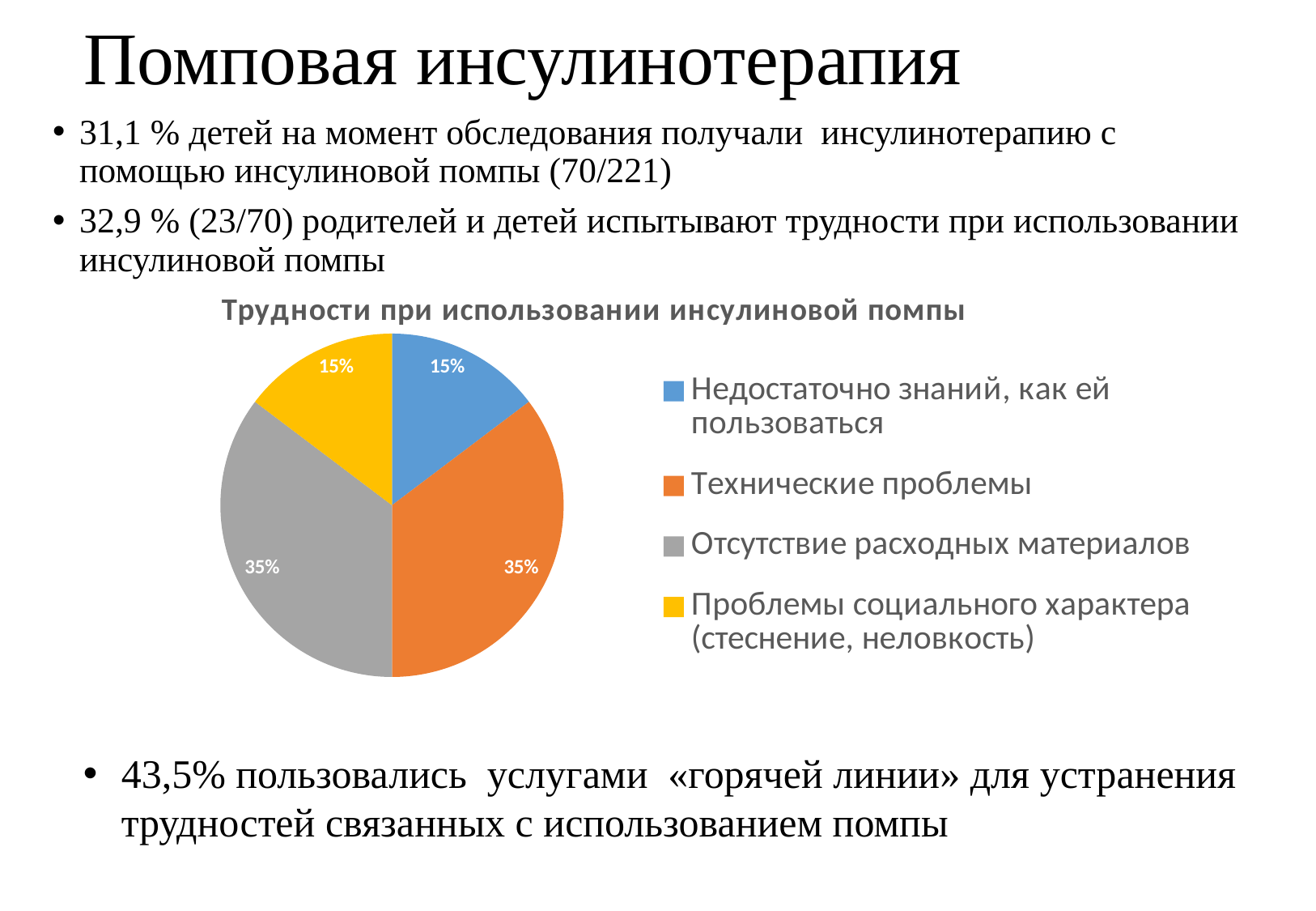
What kind of chart is shown on the slide? Pie chart What is the difference in percentage points between the share for 'Отсутствие расходных материалов' and the share for 'Проблемы социального характера (стеснение, неловкость)'? 20 What share of the pie is 'Проблемы социального характера (стеснение, неловкость)'? 15% What share of the pie is 'Недостаточно знаний, как ей пользоваться'? 15% What share of the pie is 'Технические проблемы'? 35% Which colour represents 'Технические проблемы' in the pie chart? Orange How many slices does the pie chart have? 4 How many entries does the chart legend list? 4 What is the title of the chart? Трудности при использовании инсулиновой помпы Which is larger: the share for 'Технические проблемы' or the share for 'Недостаточно знаний, как ей пользоваться'? Технические проблемы Which is larger: the share for 'Проблемы социального характера (стеснение, неловкость)' or the share for 'Отсутствие расходных материалов'? Отсутствие расходных материалов